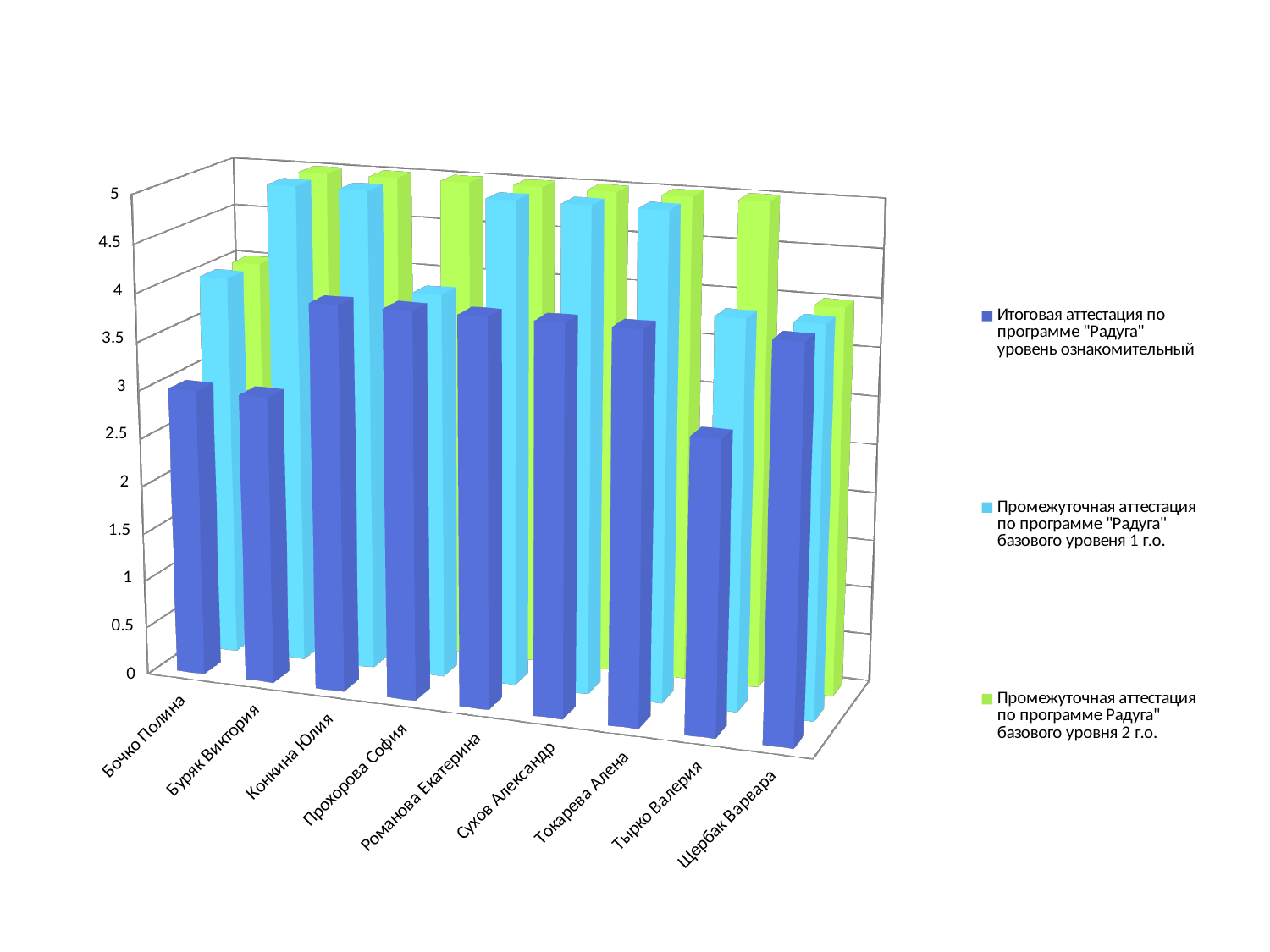
Is the value for Щербак Варвара in the series "Промежуточная аттестация по программе Радуга" базового уровня 2 г.о." greater or less than 5? less For Бочко Полина, which is larger: the value for "Итоговая аттестация по программе "Радуга" уровень ознакомительный" or the value for "Промежуточная аттестация по программе "Радуга" базового уровеня 1 г.о."? Промежуточная аттестация по программе "Радуга" базового уровеня 1 г.о. What colour are the bars for the series "Промежуточная аттестация по программе Радуга" базового уровня 2 г.о."? green How many students (categories) are shown on the x axis of the chart? 9 Is the value for Конкина Юлия in the series "Промежуточная аттестация по программе "Радуга" базового уровеня 1 г.о." greater or less than 4? greater What colour are the bars for the series "Итоговая аттестация по программе "Радуга" уровень ознакомительный"? dark blue What kind of chart is shown on the slide? bar chart How many series does the chart's legend list? 3 For Тырко Валерия, which is larger: the value for "Итоговая аттестация по программе "Радуга" уровень ознакомительный" or the value for "Промежуточная аттестация по программе "Радуга" базового уровеня 1 г.о."? Промежуточная аттестация по программе "Радуга" базового уровеня 1 г.о. Is the value for Бочко Полина in the series "Итоговая аттестация по программе "Радуга" уровень ознакомительный" greater or less than 4? less